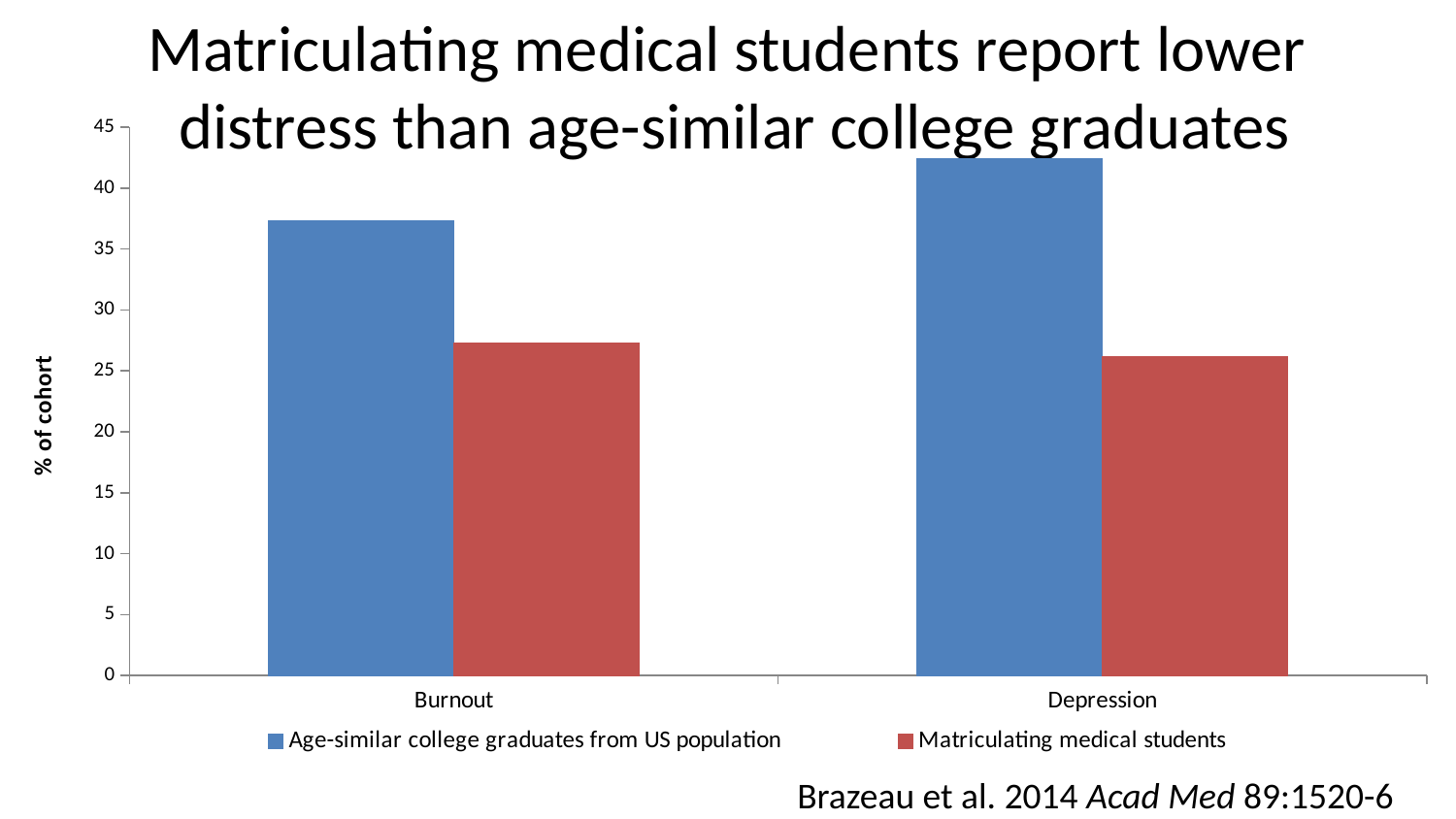
What is the label of the y axis? % of cohort Is the value for Age-similar college graduates from US population for Depression greater or less than 40? greater Is the value for Matriculating medical students for Depression greater or less than 30? less How many series does the legend list? 2 How many categories are shown on the x axis? 2 For Depression, which series has the larger value: Age-similar college graduates from US population or Matriculating medical students? Age-similar college graduates from US population Is the value for Age-similar college graduates from US population for Burnout greater or less than 35? greater What kind of chart is shown on the slide? bar chart For Age-similar college graduates from US population, which category has the higher value: Burnout or Depression? Depression For Burnout, which series has the larger value: Age-similar college graduates from US population or Matriculating medical students? Age-similar college graduates from US population Which series is shown in red? Matriculating medical students